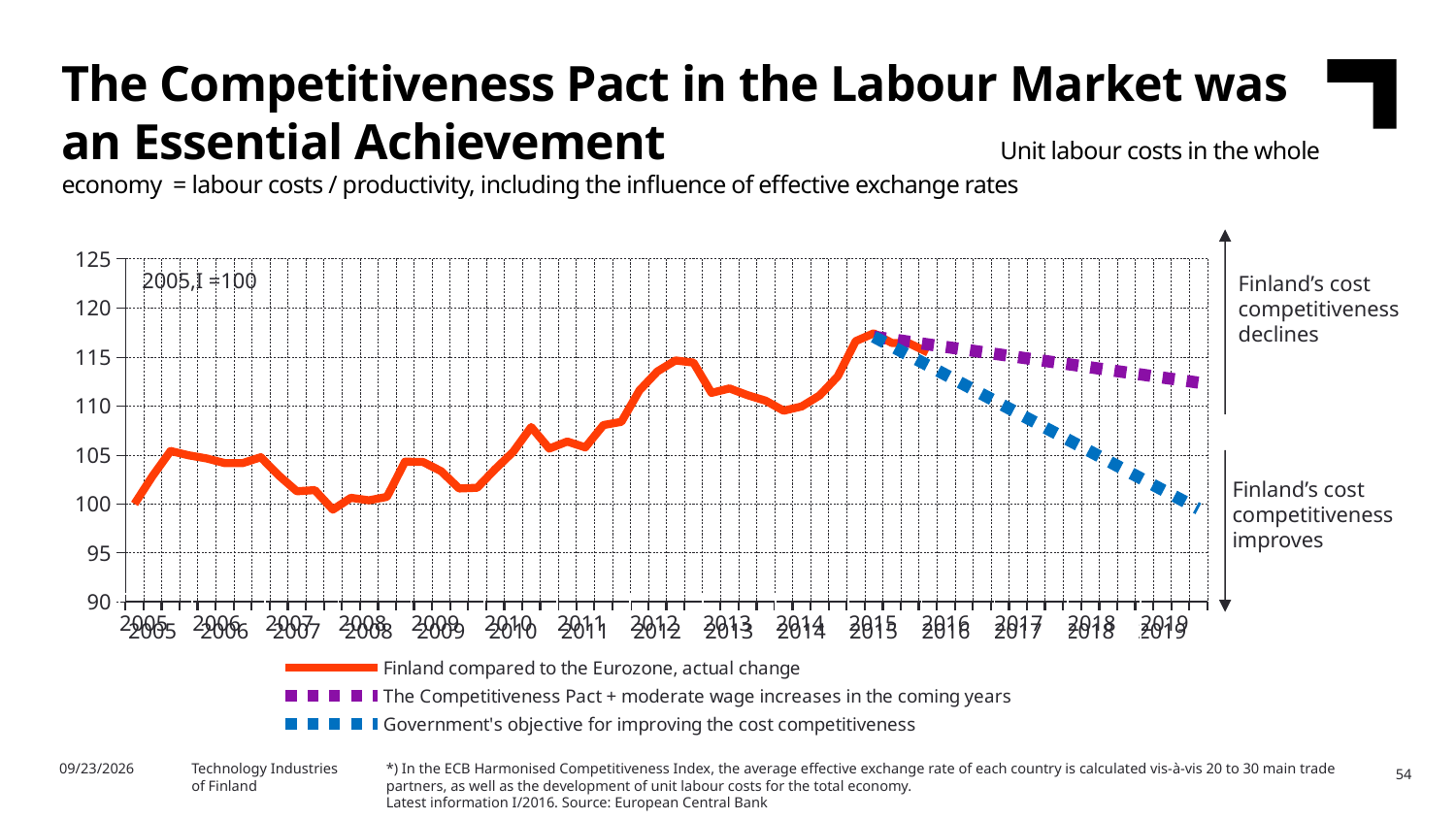
Which series is drawn as a solid red line according to the legend? Finland compared to the Eurozone, actual change Does the red line rise or fall between 2014 and 2015? rise How many series does the legend list? 3 Is the peak value of the red 'Finland compared to the Eurozone, actual change' line around 2015 greater or less than 115? greater Is the value of the blue dashed 'Government's objective' line at 2019 greater or less than 105? less Does the blue dashed 'Government's objective' line rise or fall from 2015 to 2019? fall At 2019, which dashed line is higher: the purple 'Competitiveness Pact' line or the blue 'Government's objective' line? the purple 'Competitiveness Pact' line What kind of chart is shown on the slide? line chart What is the index value of the red line at the start of 2005, according to the annotation on the chart? 100 What is the highest value shown on the y axis? 125 Is the value of the red line in 2009 greater or less than 105? less